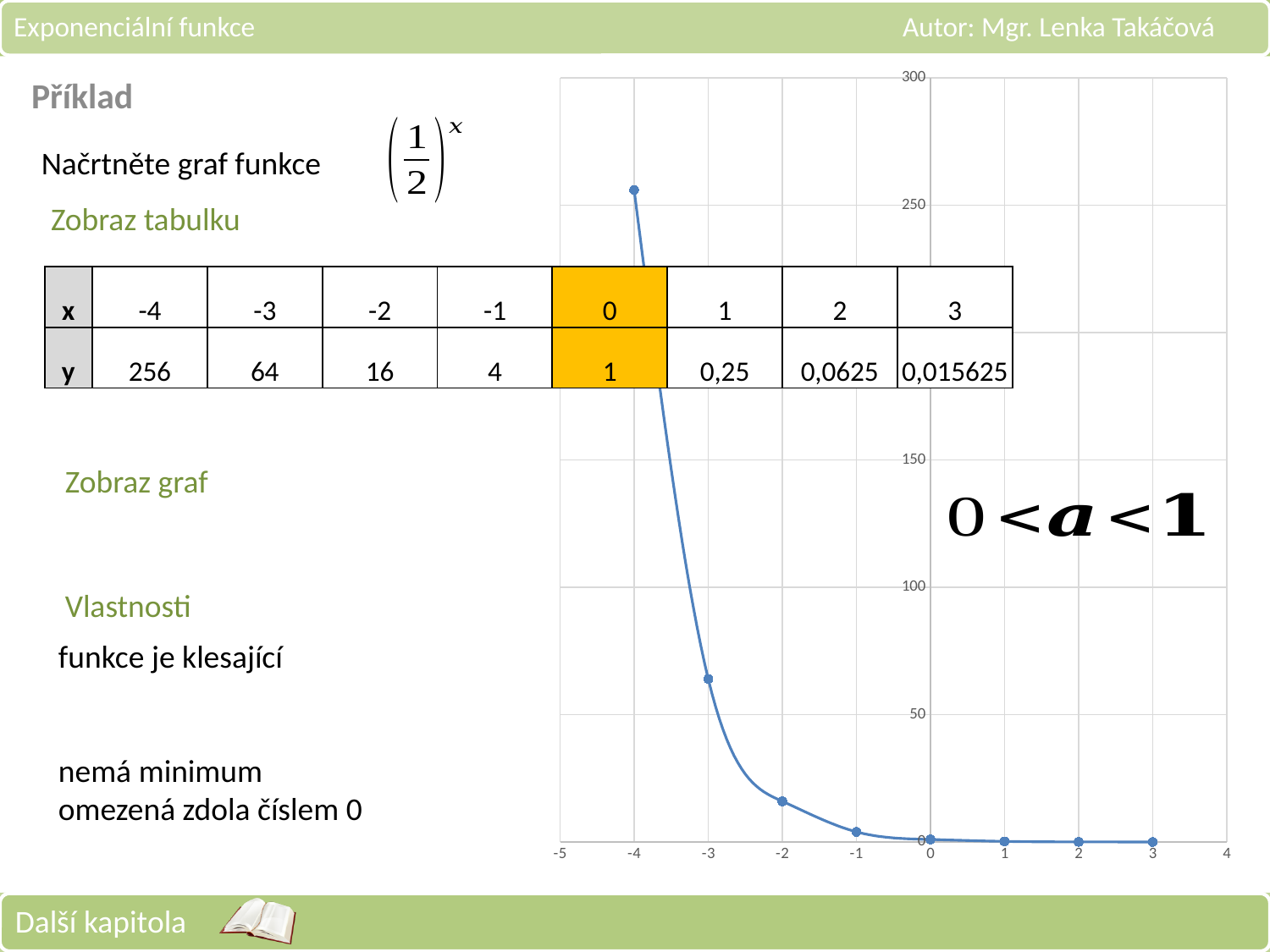
Do the plotted values rise or fall as x increases along the x axis? fall What kind of chart is shown on the slide? line chart Is the plotted value at x = -4 greater or less than 250? greater What is the y value plotted at x = -4? 256 Which is larger, the plotted value at x = -3 or at x = -2? x = -3 What is the difference between the plotted values at x = -4 and x = -3? 192 At which x value is the plotted y value lowest? 3 At which x value is the plotted y value highest? -4 What is the y value plotted at x = 3? 0,015625 Is the plotted value at x = -3 greater or less than 100? less How many data points are plotted on the chart? 8 What is the y value plotted at x = -3? 64